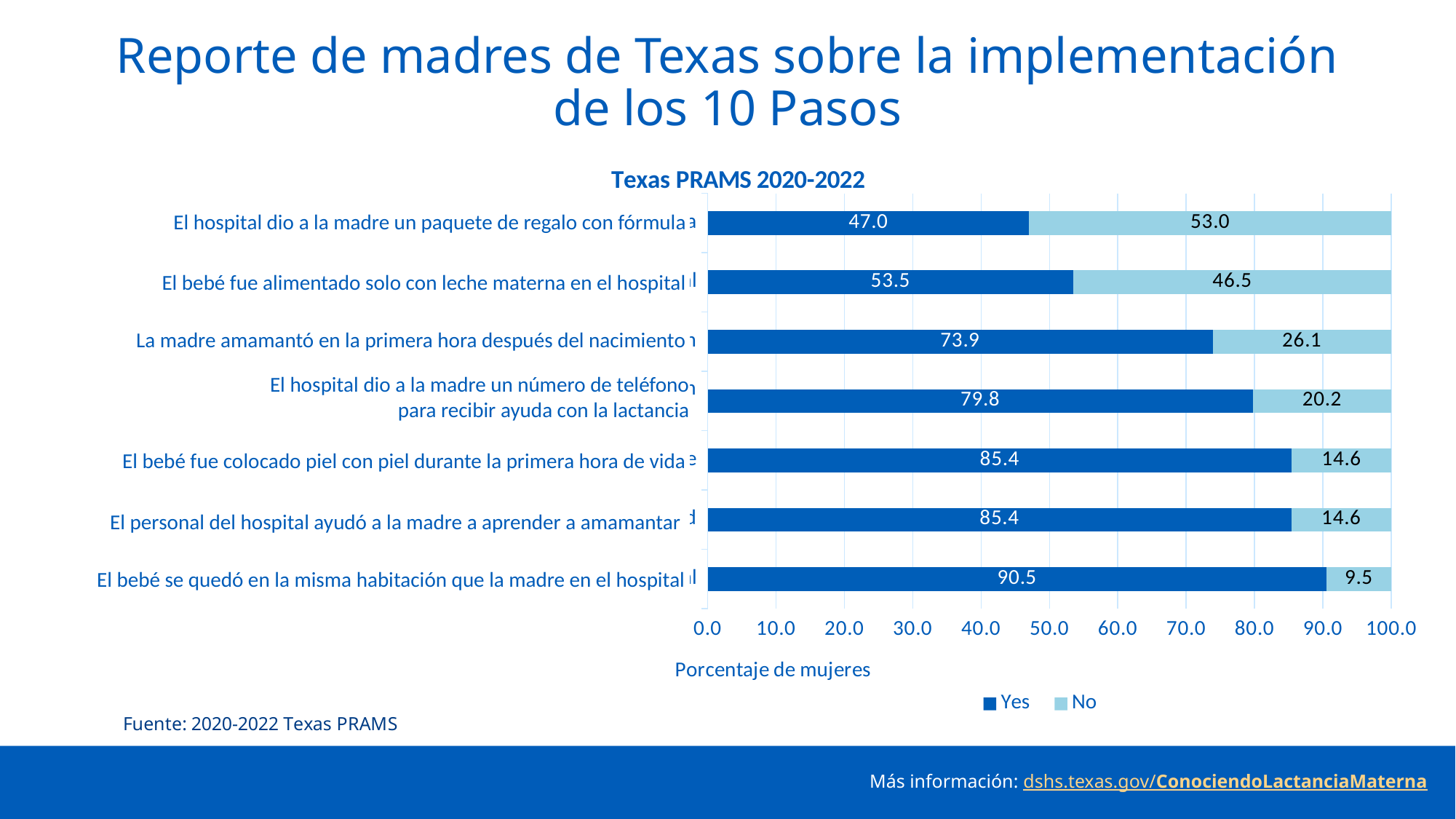
What is the 'Yes' value for 'El bebé se quedó en la misma habitación que la madre en el hospital'? 90.5 What is the title of the chart? Texas PRAMS 2020-2022 What is the 'No' value for 'El hospital dio a la madre un número de teléfono para recibir ayuda con la lactancia'? 20.2 What is the 'No' value for 'El hospital dio a la madre un paquete de regalo con fórmula'? 53.0 What is the 'Yes' value for 'La madre amamantó en la primera hora después del nacimiento'? 73.9 What kind of chart is shown on the slide? Stacked bar chart Which category has the highest 'Yes' value? El bebé se quedó en la misma habitación que la madre en el hospital What is the difference between the 'Yes' and 'No' values for 'El bebé fue alimentado solo con leche materna en el hospital'? 7.0 How many series does the legend list? 2 Which is larger: the 'Yes' value for 'El bebé fue colocado piel con piel durante la primera hora de vida' or the 'Yes' value for 'La madre amamantó en la primera hora después del nacimiento'? El bebé fue colocado piel con piel durante la primera hora de vida How many categories are shown in the chart? 7 Which category has the lowest 'Yes' value? El hospital dio a la madre un paquete de regalo con fórmula